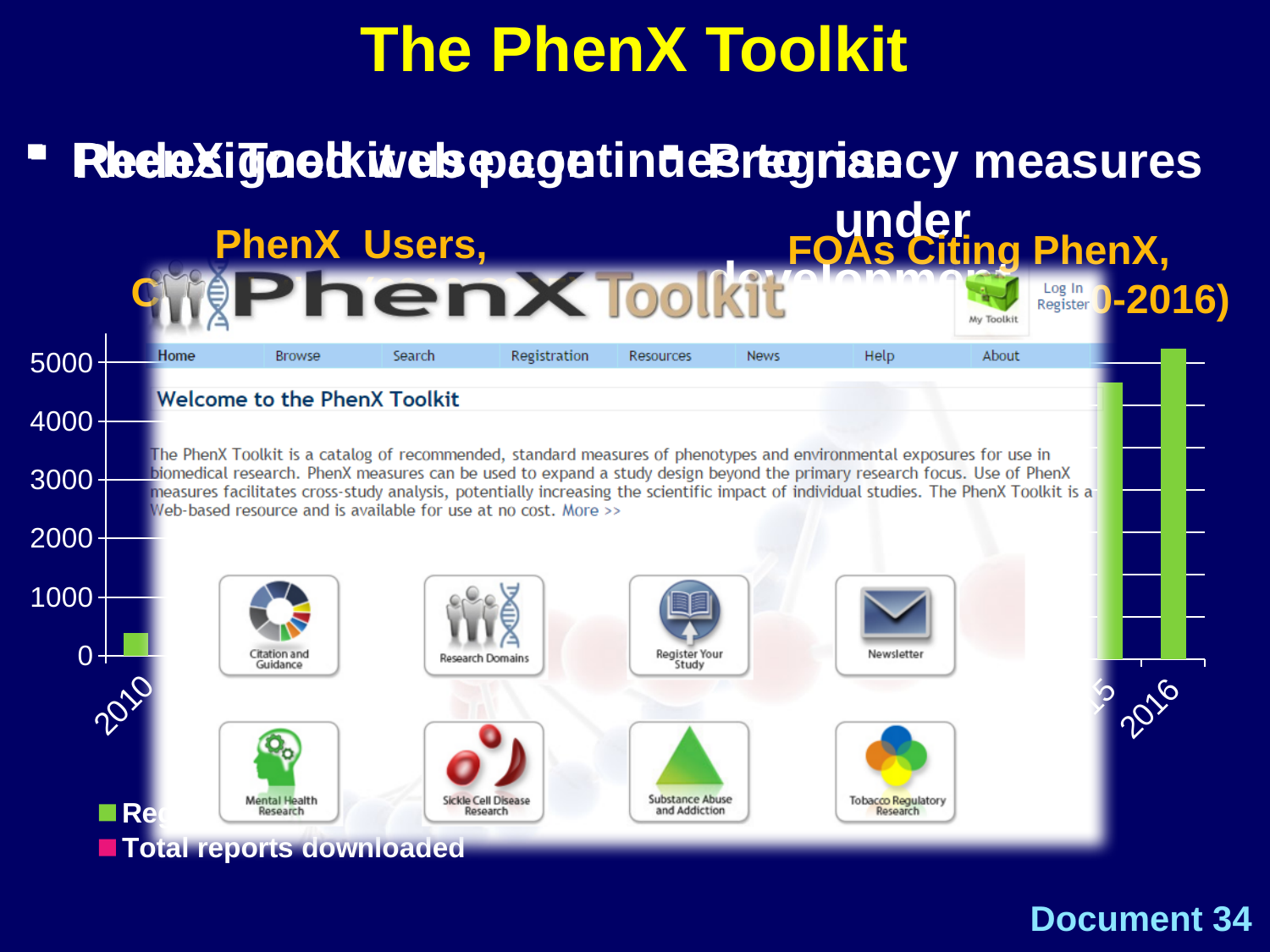
What is the highest value labelled on the vertical axis? 5000 Is the green bar for 2010 greater or less than 1000? less How many series does the legend list? 2 Do the green bars rise or fall from 2010 to 2016? rise Which year has the taller green bar, 2015 or 2016? 2016 What is the second legend entry, shown with a pink marker? Total reports downloaded What kind of chart is shown on the slide? bar chart